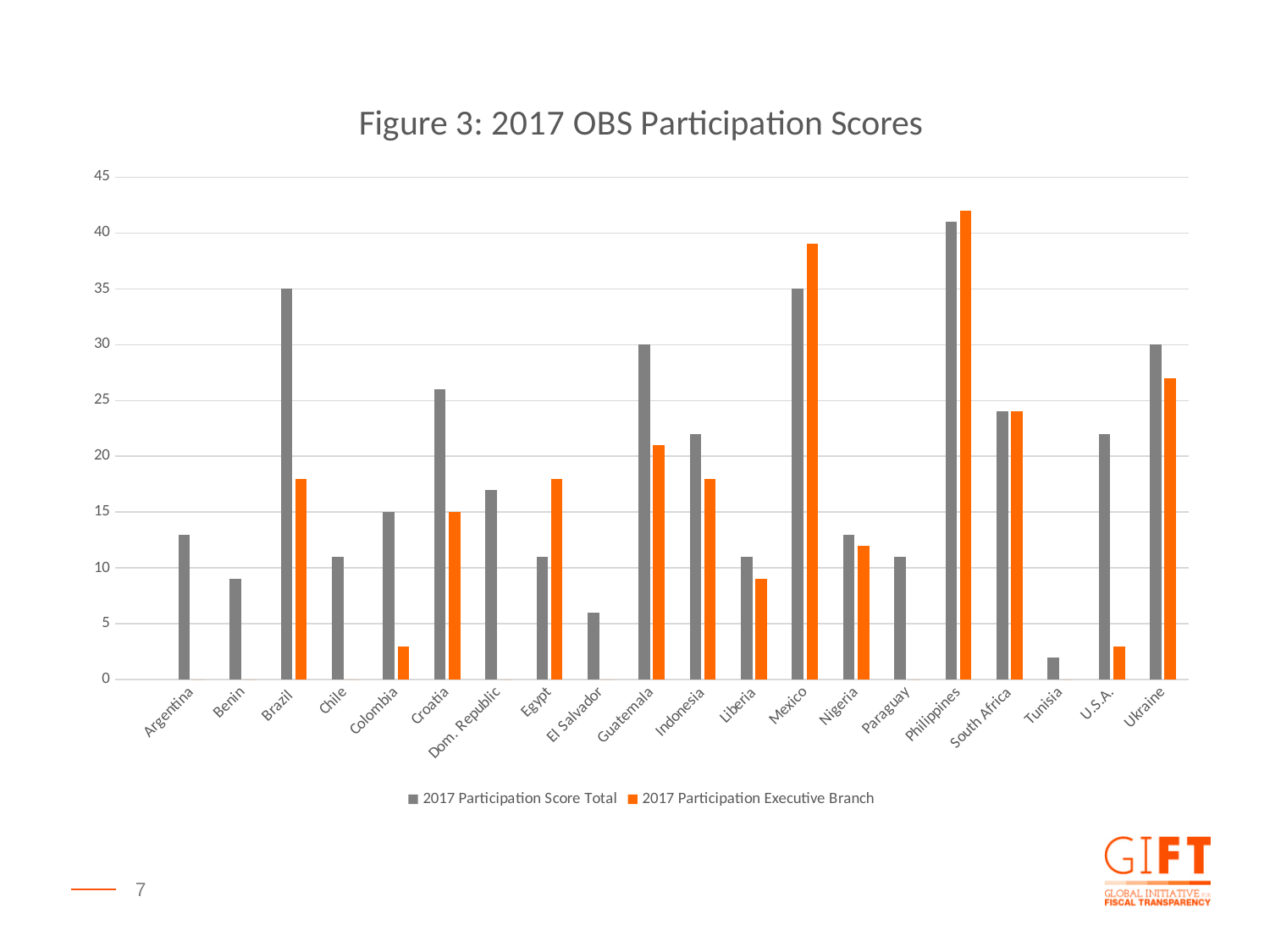
Which is larger for Brazil: the 2017 Participation Score Total or the 2017 Participation Executive Branch score? 2017 Participation Score Total Which country has the highest 2017 Participation Executive Branch score? Philippines Which is larger for Mexico: the 2017 Participation Score Total or the 2017 Participation Executive Branch score? 2017 Participation Executive Branch Is the 2017 Participation Score Total for Croatia greater or less than 25? greater Which country has the highest 2017 Participation Score Total? Philippines How many series does the legend list? 2 What kind of chart is shown on the slide? bar chart Is the 2017 Participation Executive Branch score for Colombia greater or less than 5? less Is the 2017 Participation Score Total for Philippines greater or less than 40? greater Which country has the lowest 2017 Participation Score Total? Tunisia How many countries are shown on the x axis of the chart? 20 What is the title of the chart? Figure 3: 2017 OBS Participation Scores